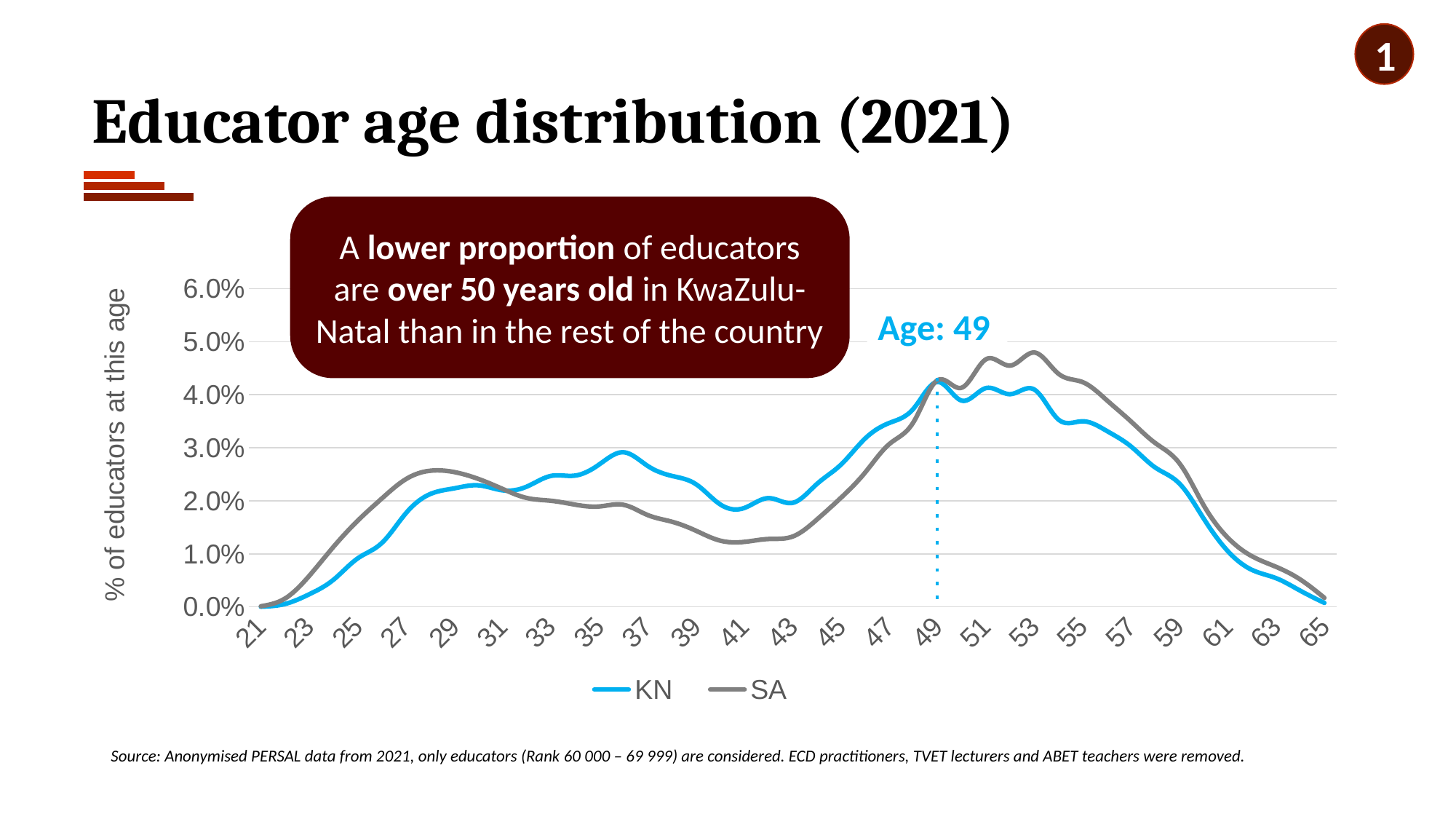
Do the values of both series rise or fall between age 55 and age 65? fall Is the SA value at age 53 greater or less than 4.0%? greater Is the KN value at age 25 greater or less than 2.0%? less How many series does the legend list? 2 Is the KN value at age 37 greater or less than 2.0%? greater What age is marked by the dotted vertical line on the chart? 49 What are the two series named in the legend? KN and SA What kind of chart is shown on the slide? line chart At which age does the SA series reach its highest value? 53 At age 41, which series has the higher value, KN or SA? KN At age 53, which series has the higher value, KN or SA? SA